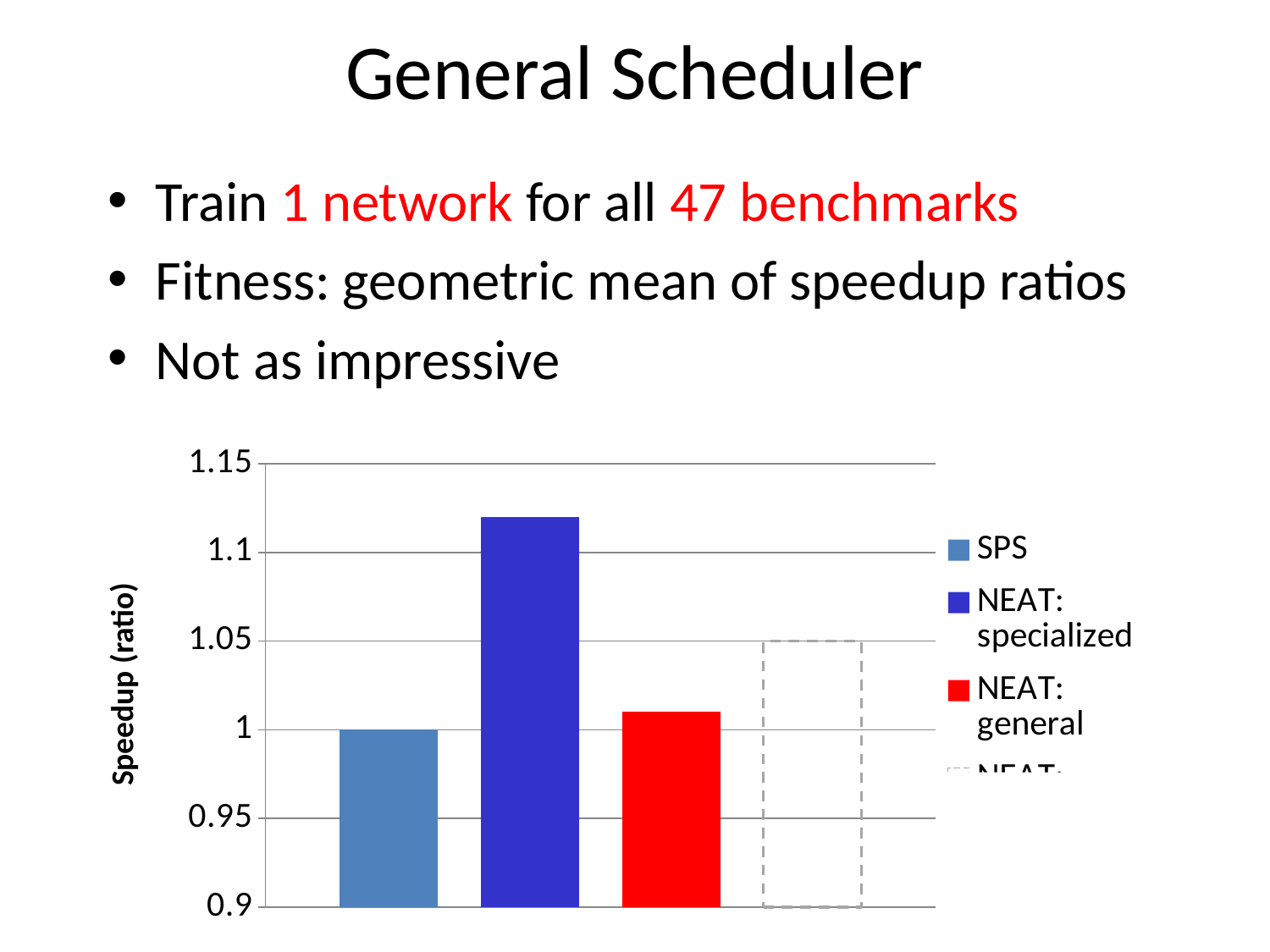
What is the lowest value shown on the vertical axis of the chart? 0.9 Is the speedup ratio for NEAT: specialized greater or less than 1.1? greater What is the speedup ratio for SPS? 1 Which series has the highest speedup ratio in the chart? NEAT: specialized Which has a larger speedup ratio, SPS or NEAT: specialized? NEAT: specialized Which has a larger speedup ratio, NEAT: specialized or NEAT: general? NEAT: specialized What is the label of the vertical axis of the chart? Speedup (ratio) What colour is the bar for NEAT: general? red Is the speedup ratio for NEAT: general greater or less than 1.05? less What kind of chart is shown on the slide? bar chart Is the speedup ratio for NEAT: specialized greater or less than 1.15? less